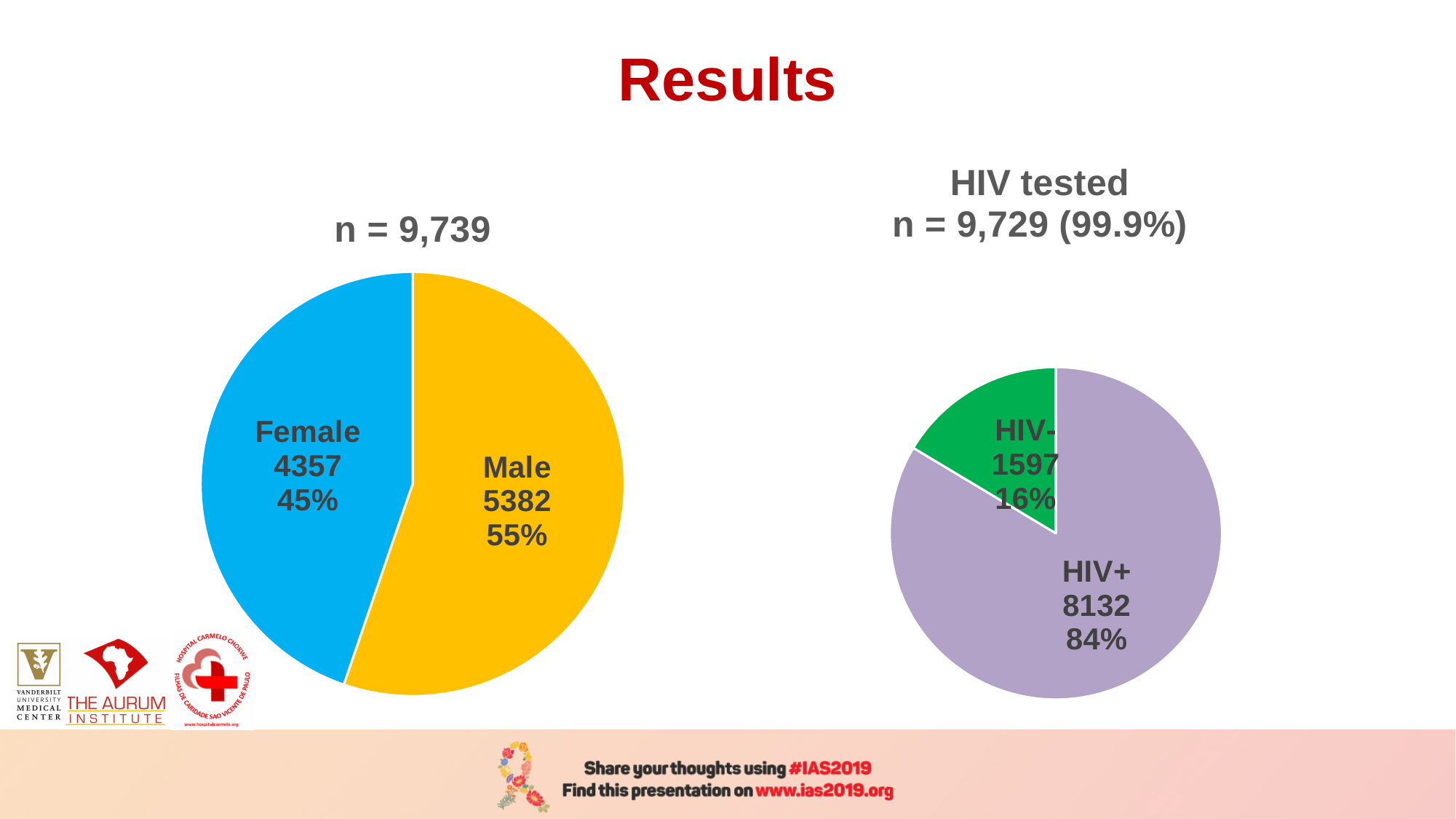
In the right pie chart titled "HIV tested", how many participants are HIV-? 1597 In the left pie chart titled "n = 9,739", what share of the pie is Male? 55% In the right pie chart titled "HIV tested", what share of the pie is HIV-? 16% In the right pie chart titled "HIV tested", which slice is the largest? HIV+ In the left pie chart titled "n = 9,739", how many participants are Female? 4357 In the right pie chart titled "HIV tested", how many participants are HIV+? 8132 How many slices does the right pie chart titled "HIV tested" have? 2 In the left pie chart titled "n = 9,739", what is the difference between the Male and Female counts? 1025 What type of chart is the left chart titled "n = 9,739"? Pie chart In the left pie chart titled "n = 9,739", which slice is larger, Female or Male? Male In the left pie chart titled "n = 9,739", how many participants are Male? 5382 In the left pie chart titled "n = 9,739", what share of the pie is Female? 45%